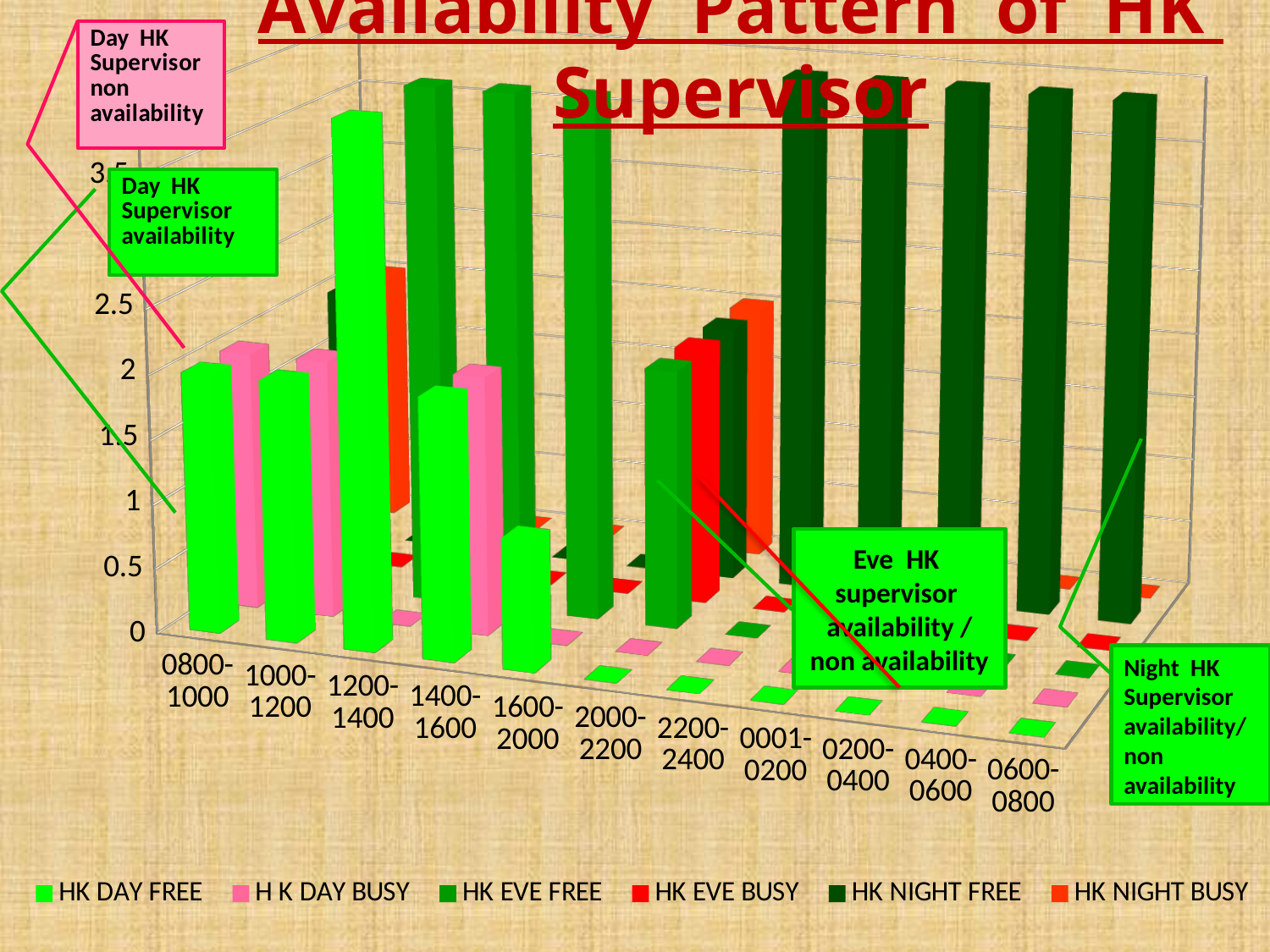
Which is larger, the HK DAY FREE value for 1200-1400 or for 1600-2000? 1200-1400 For the HK DAY FREE series, which time slot has the highest value? 1200-1400 Is the HK DAY FREE value for 1200-1400 greater or less than 2.5? greater How many series does the legend list? 6 What is the title of the chart? Availability Pattern of HK Supervisor Is the HK DAY FREE value for 0800-1000 greater or less than 1? greater What kind of chart is shown on the slide? bar chart Which series is shown in pink in the legend? H K DAY BUSY How many time-slot categories are shown on the x axis? 11